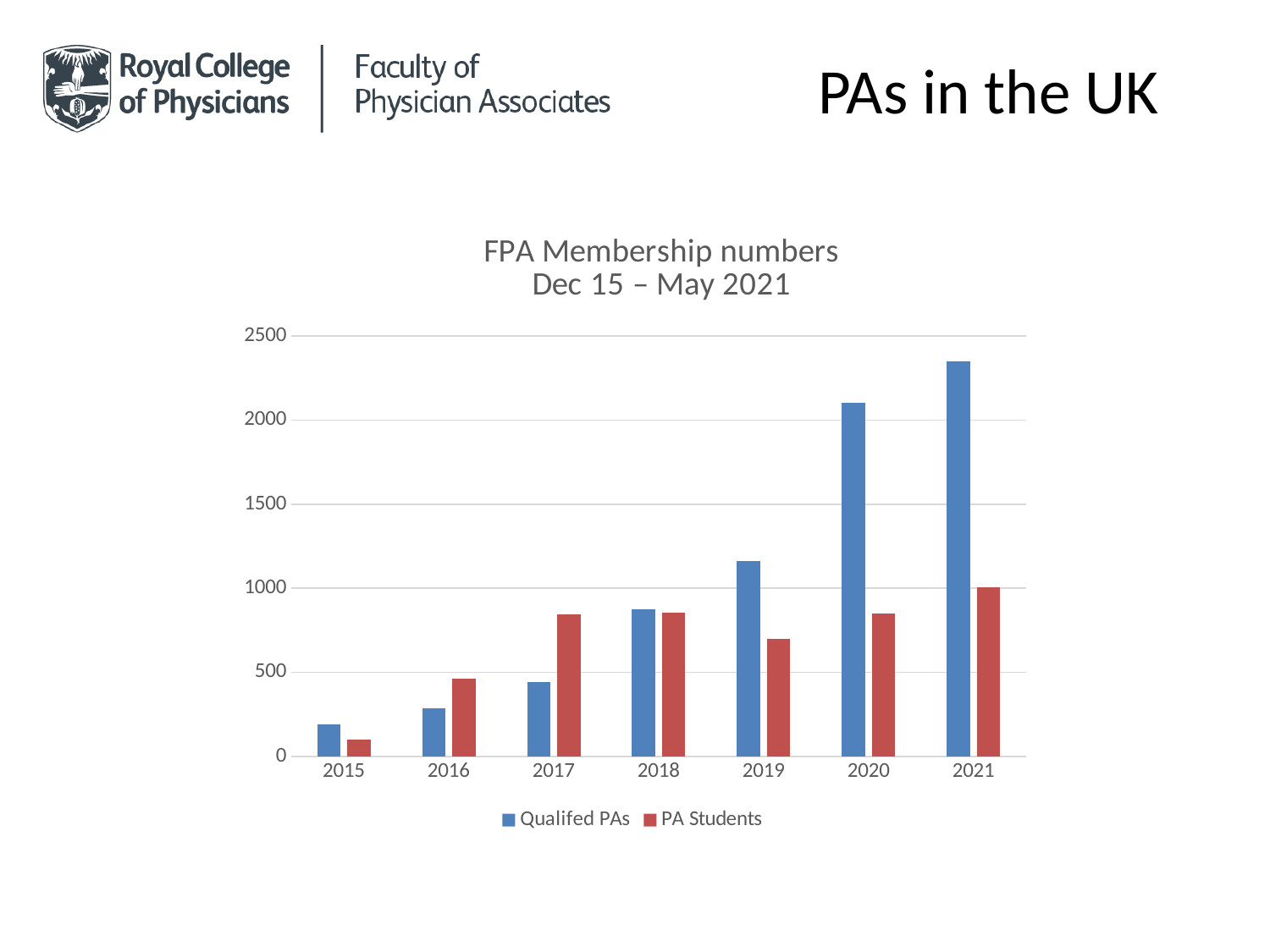
In 2016, which is larger: Qualifed PAs or PA Students? PA Students Which year has the lowest value for PA Students? 2015 Do the values for Qualifed PAs rise or fall from 2015 to 2021? rise Which year has the highest value for Qualifed PAs? 2021 Which year has the highest value for PA Students? 2021 How many series does the legend list? 2 How many years are shown on the x axis? 7 Is the value for Qualifed PAs in 2020 greater or less than 2000? greater Is the value for Qualifed PAs in 2017 greater or less than 500? less Is the value for PA Students in 2019 greater or less than 500? greater What kind of chart is shown on the slide? bar chart What is the title of the chart? FPA Membership numbers Dec 15 – May 2021